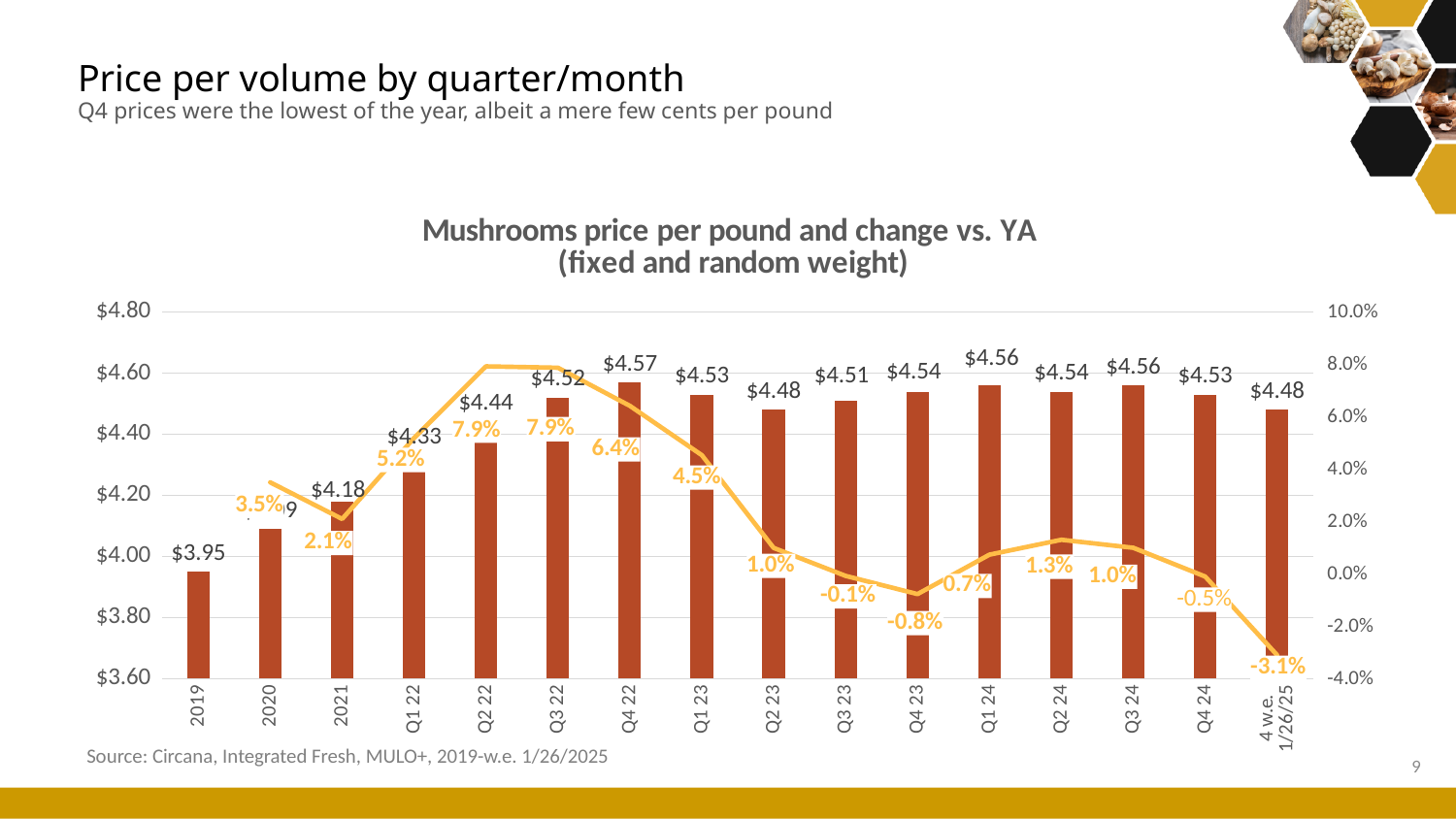
How many periods are shown on the x axis? 16 What kind of chart is this? Combination bar and line chart Which has the higher price per pound, Q1 24 or Q4 24? Q1 24 Is the price per pound bar for 2020 greater or less than $4.20? less What is the difference in price per pound between Q4 22 and 2019? $0.62 Which period has the lowest price per pound? 2019 What is the price per pound shown for Q3 24? $4.56 What is the change vs. YA shown for the 4 w.e. 1/26/25 period? -3.1% What is the change vs. YA shown for Q4 23? -0.8% Which period has the lowest change vs. YA on the line? 4 w.e. 1/26/25 What is the mushroom price per pound for Q4 22? $4.57 Which period has the highest price per pound? Q4 22